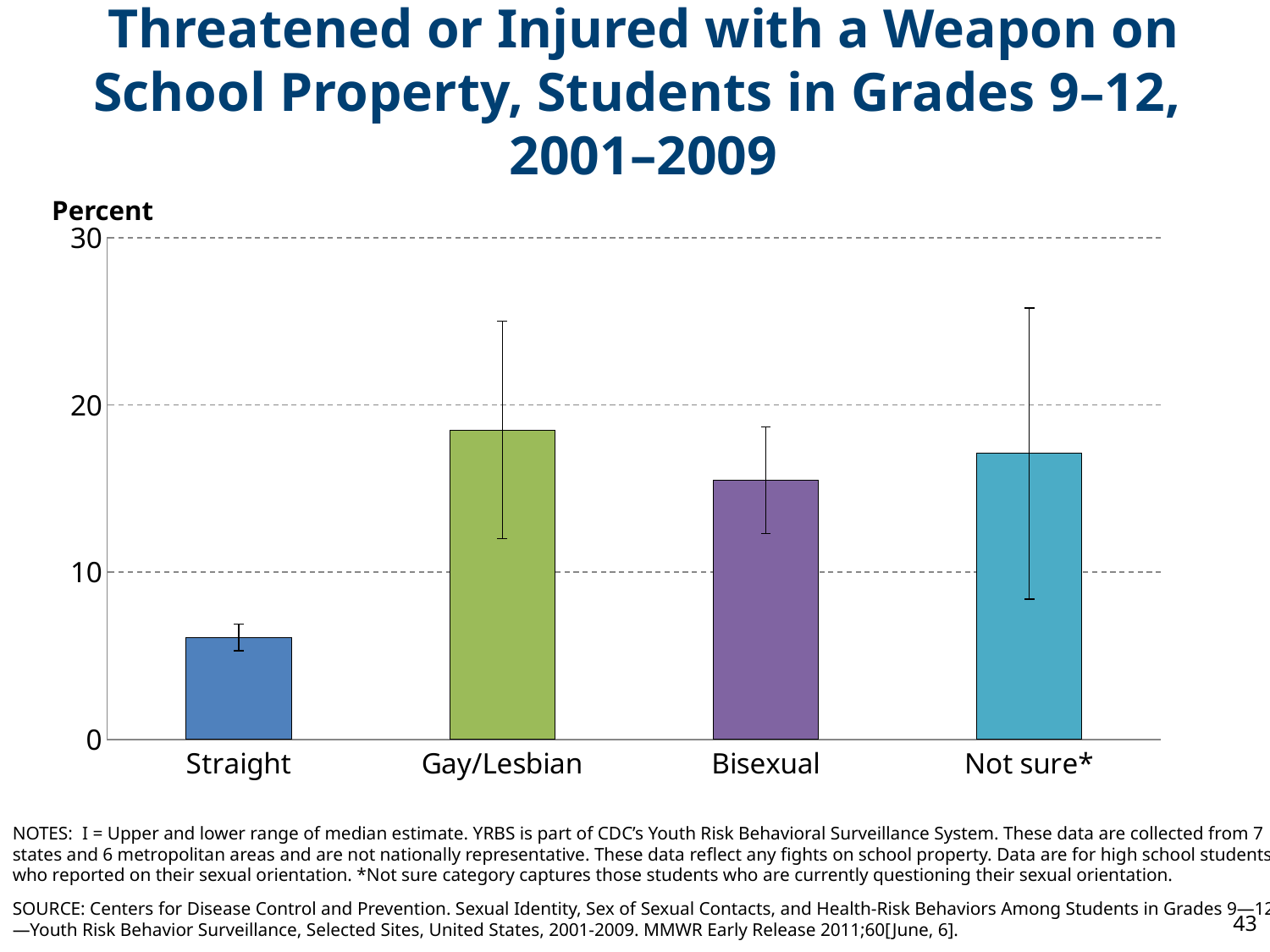
What is the label on the y axis? Percent Is the value for Straight greater or less than 10? less Which is larger, the value for Gay/Lesbian or the value for Bisexual? Gay/Lesbian How many categories are shown on the x axis? 4 Is the value for Gay/Lesbian greater or less than 20? less What is the highest value shown on the y axis? 30 Is the value for Not sure* greater or less than 20? less Which category has the lowest value? Straight Which category has the highest value? Gay/Lesbian Which is larger, the value for Straight or the value for Bisexual? Bisexual What kind of chart is shown on the slide? bar chart